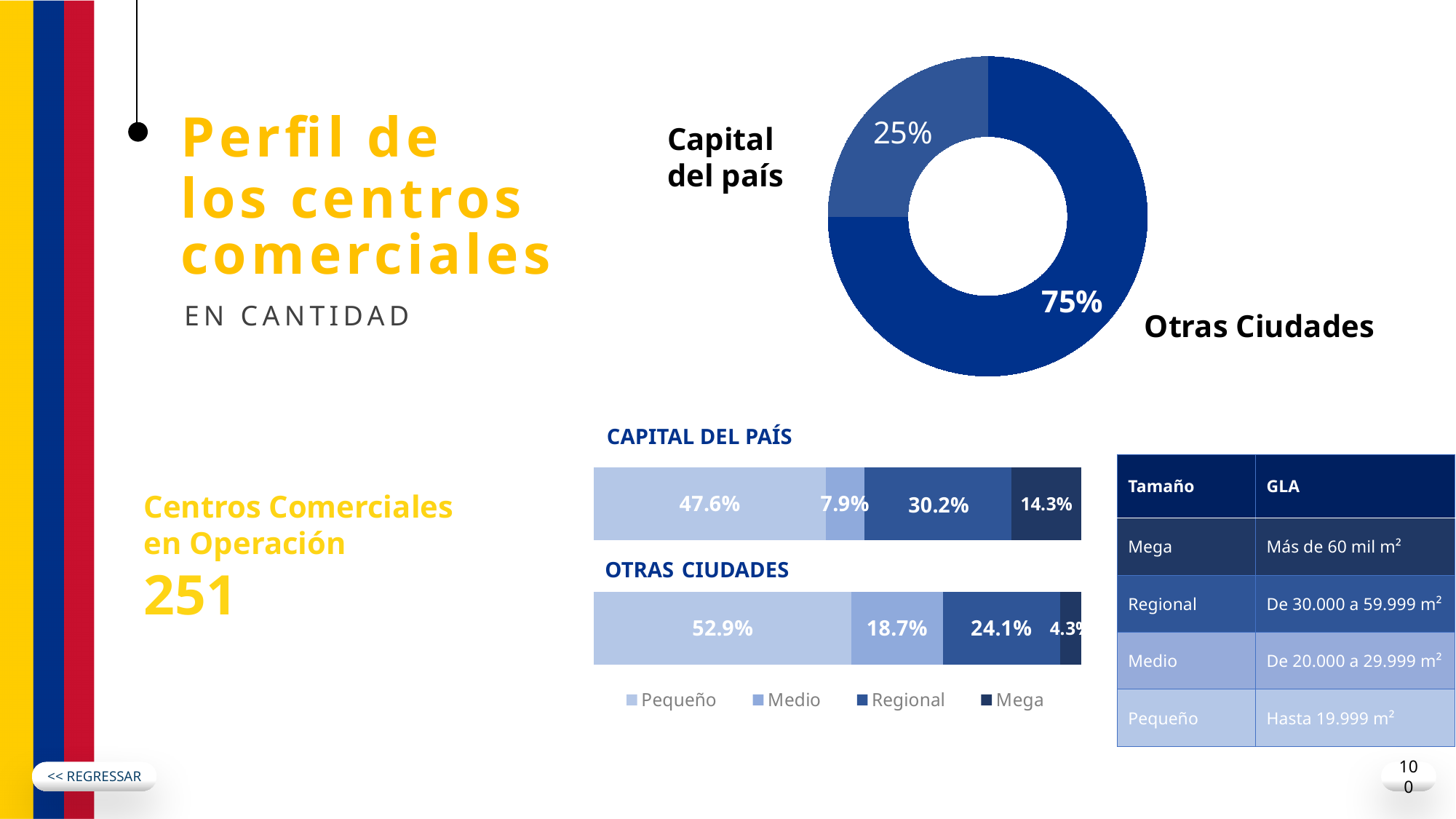
In the stacked bar chart, is the Regional share larger for Capital del país or for Otras Ciudades? Capital del país In the donut chart, which segment is larger, Capital del país or Otras Ciudades? Otras Ciudades In the stacked bar chart, what is the difference between the Medio share in Otras Ciudades and in Capital del país? 10.8% What kind of chart is the one at the top right showing Capital del país and Otras Ciudades? Donut (pie) chart In the stacked bar chart, which size category has the smallest share in Capital del país? Medio In the stacked bar chart, what is the Mega share for Otras Ciudades? 4.3% In the stacked bar chart, what is the Regional share for Capital del país? 30.2% In the donut chart, what share of shopping centres is in the Capital del país? 25% In the stacked bar chart, what is the Pequeño share for Capital del país? 47.6% In the stacked bar chart, which size category has the largest share in Otras Ciudades? Pequeño In the donut chart, what share of shopping centres is in Otras Ciudades? 75% How many series does the legend of the stacked bar chart list? 4